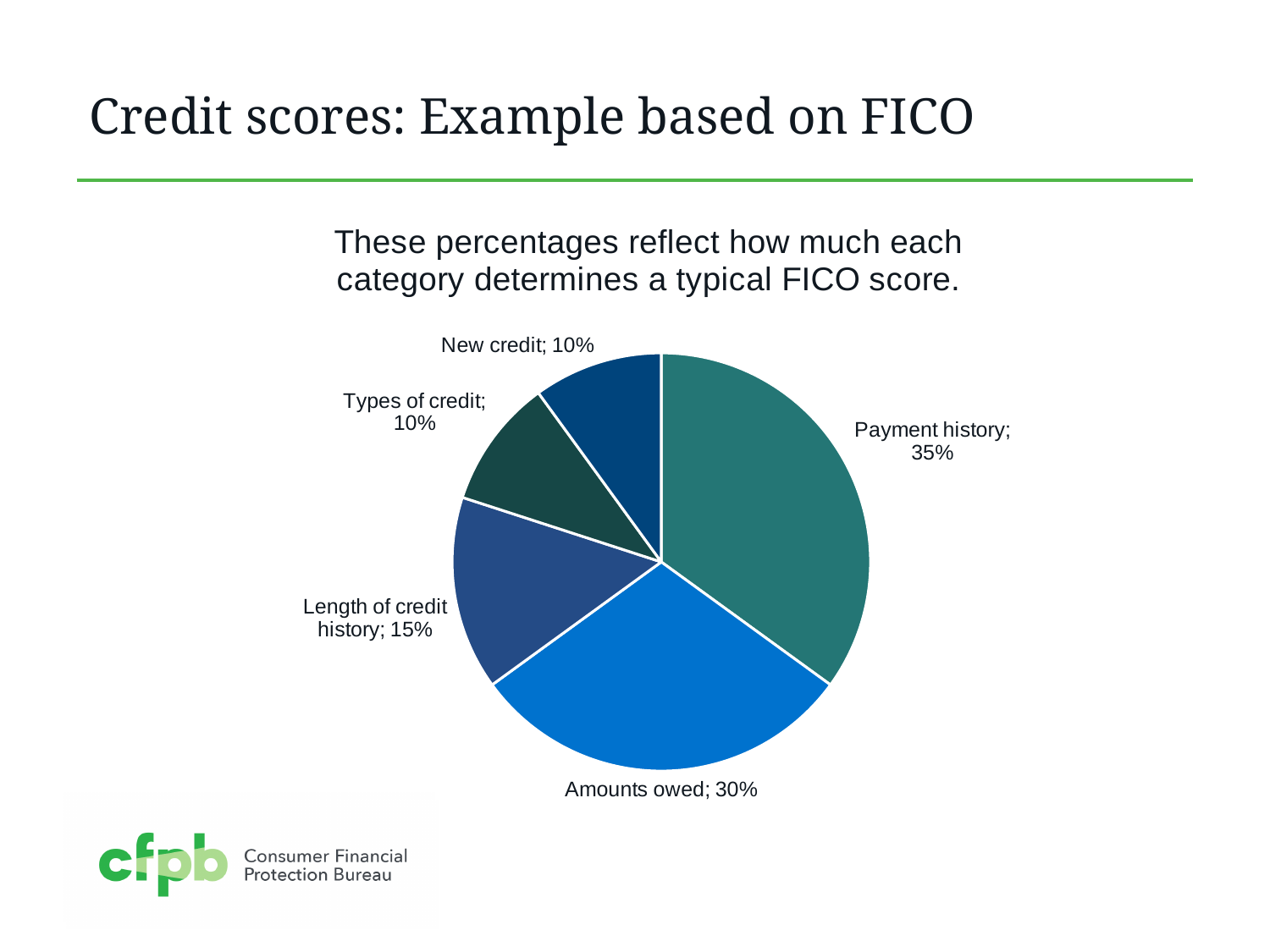
What percentage does Payment history account for? 35% How many slices does the pie chart have? 5 What percentage does Amounts owed account for? 30% What is the title of the slide containing the pie chart? Credit scores: Example based on FICO What is the difference between the Payment history and Amounts owed percentages? 5% Which is larger, Length of credit history or Types of credit? Length of credit history What percentage does New credit account for? 10% Which two categories share the smallest percentage? Types of credit and New credit What percentage does Length of credit history account for? 15% Which category has the largest share of the pie? Payment history What kind of chart is shown on the slide? pie chart What is the difference between the Amounts owed and Length of credit history percentages? 15%